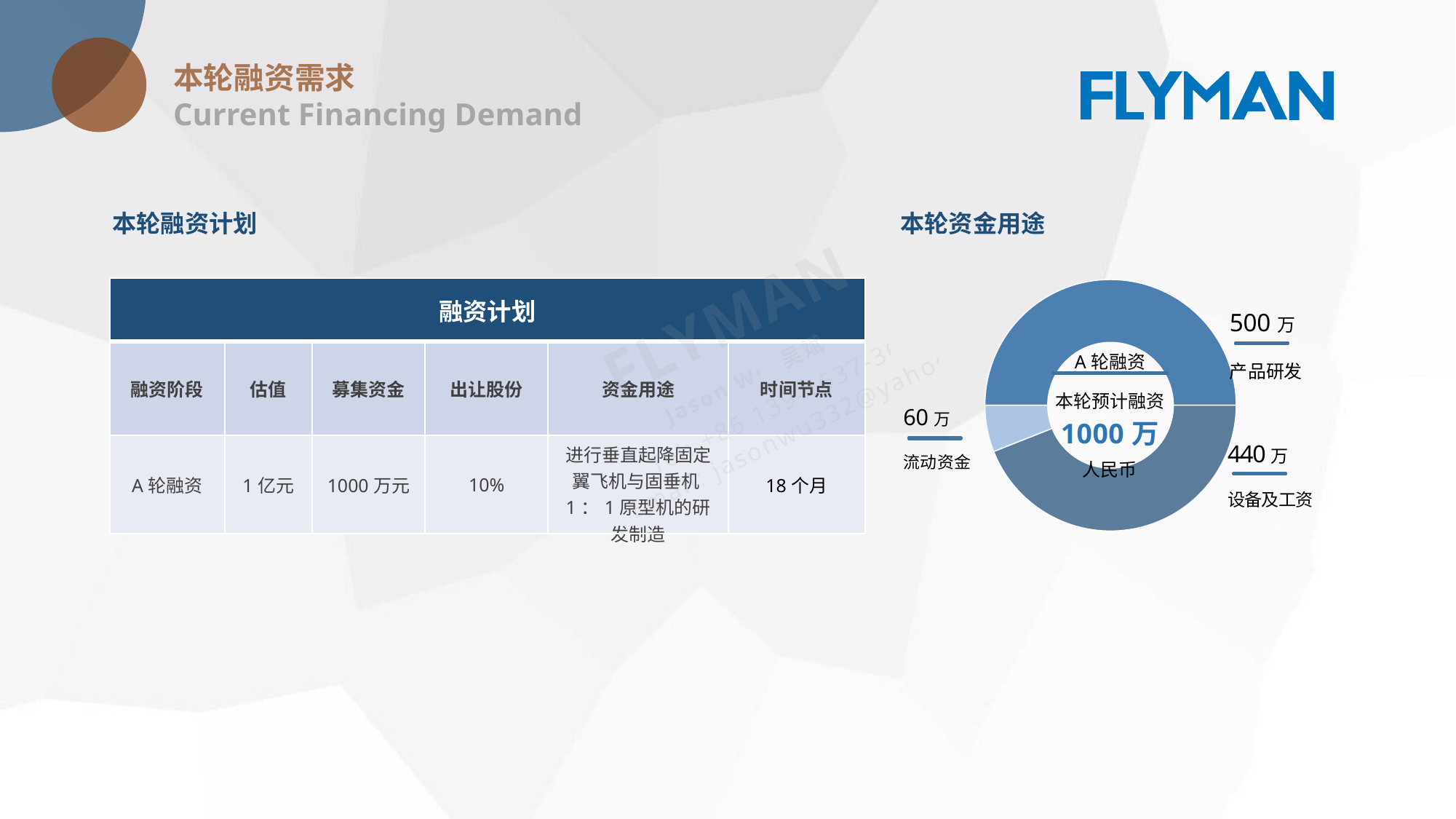
In the 本轮资金用途 chart, what is the value for 设备及工资? 440 万 In the 本轮资金用途 chart, what is the difference between 设备及工资 and 流动资金? 380 万 What total financing amount is printed in the centre of the 本轮资金用途 chart? 1000 万 人民币 In the 本轮资金用途 chart, which is larger, 设备及工资 or 流动资金? 设备及工资 In the 本轮资金用途 chart, which category has the smallest value? 流动资金 In the 本轮资金用途 chart, what share of the total does 产品研发 represent? 50% How many categories does the 本轮资金用途 chart show? 3 In the 本轮资金用途 chart, what is the value for 流动资金? 60 万 In the 本轮资金用途 chart, what is the difference between 产品研发 and 设备及工资? 60 万 What kind of chart is shown under 本轮资金用途? Donut (pie) chart In the 本轮资金用途 chart, which category has the largest value? 产品研发 In the 本轮资金用途 chart, what is the value for 产品研发? 500 万